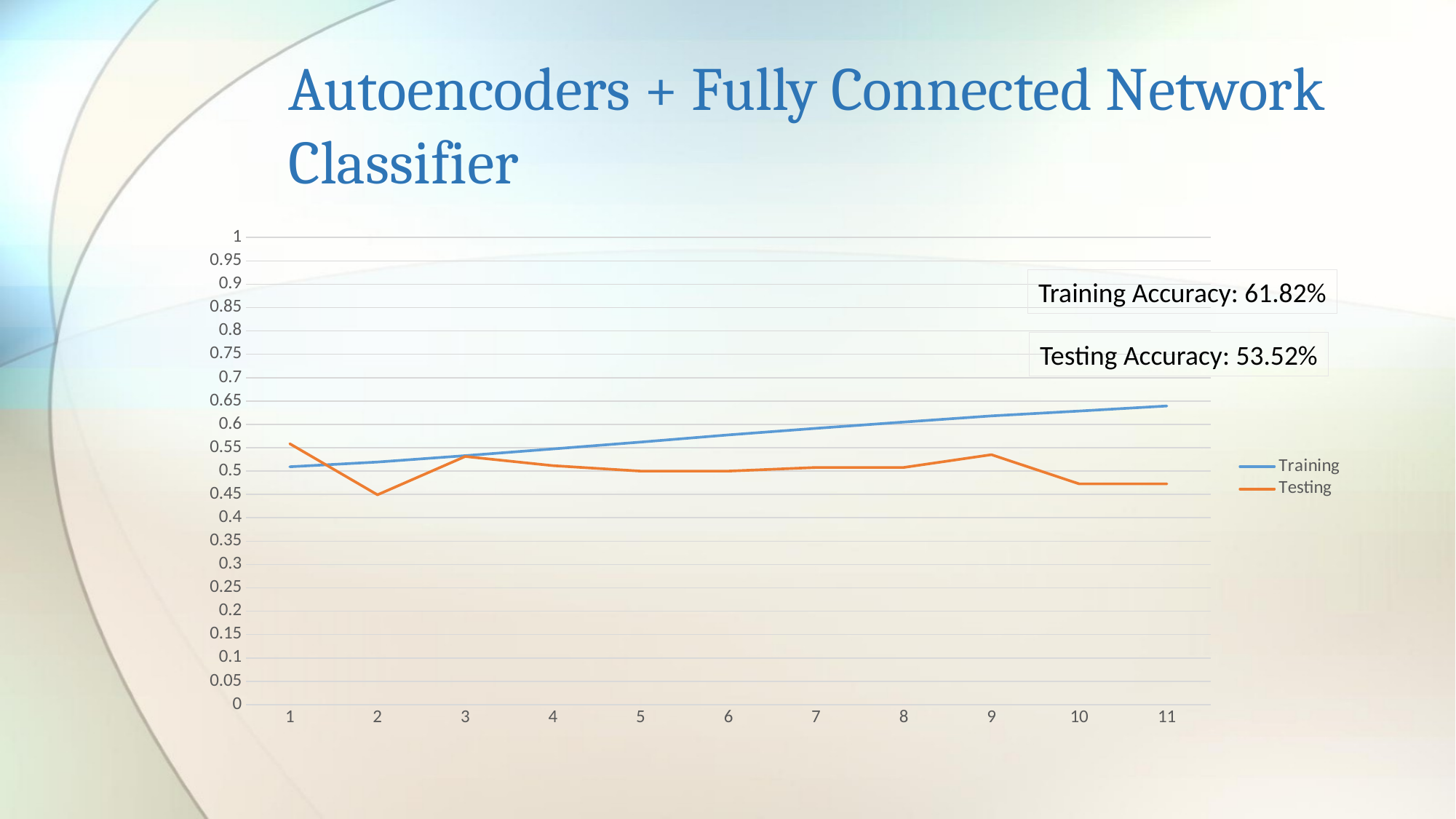
At which x value is the Training series highest? 11 What colour is the Testing line in the legend? orange Does the Training line rise or fall from x = 1 to x = 11? rise How many series does the legend list? 2 Is the Testing value at x = 2 greater or less than 0.5? less How many points are plotted along the x axis for each series? 11 What kind of chart is shown on the slide? line chart At which x value is the Testing series lowest? 2 Is the Training value at x = 11 greater or less than 0.6? greater Is the Testing value at x = 10 greater or less than 0.5? less At x = 1, which series has the larger value, Training or Testing? Testing At x = 11, which series has the larger value, Training or Testing? Training